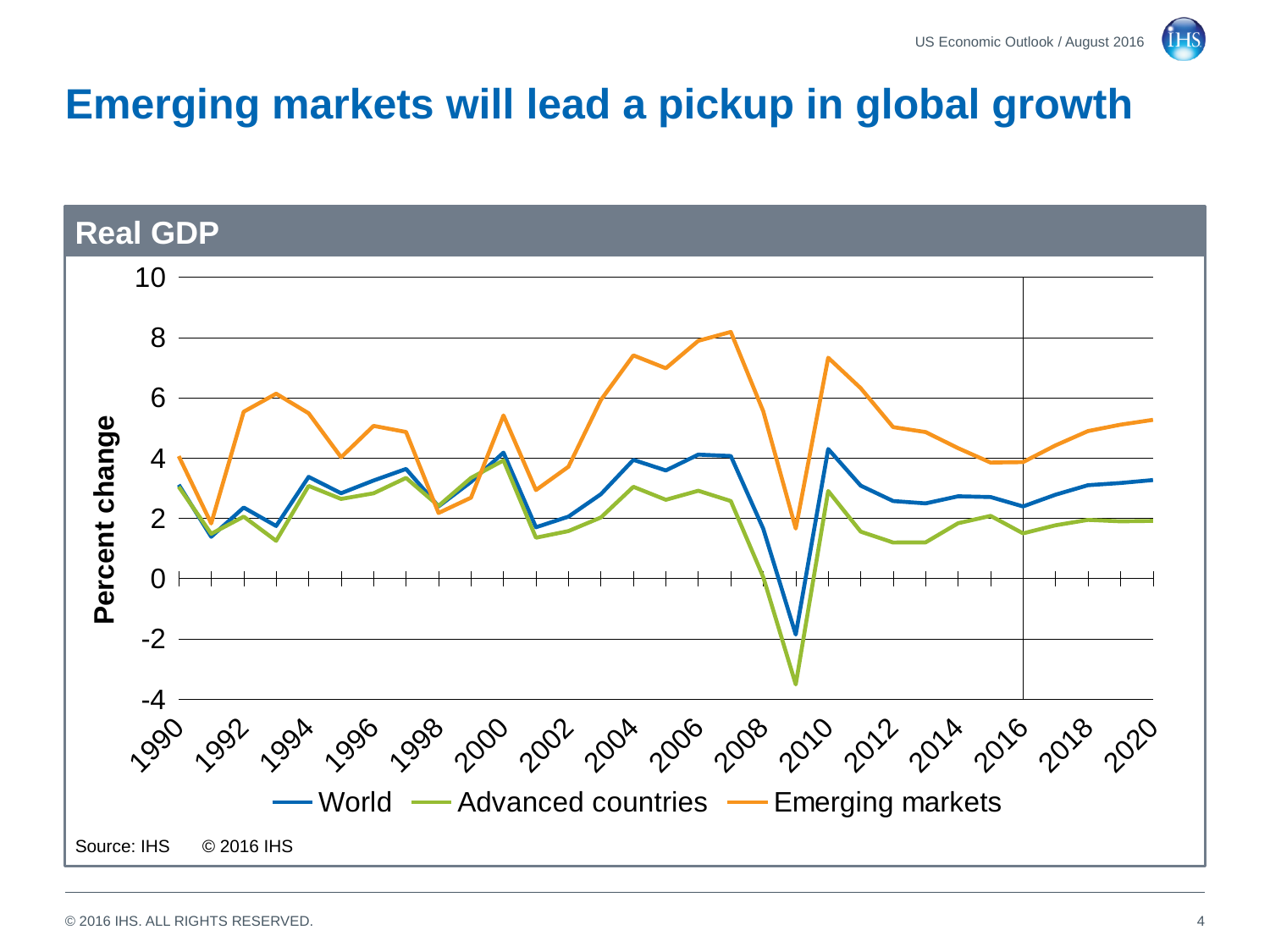
What kind of chart is shown on the slide? Line chart Does the Emerging markets series rise or fall from 2016 to 2020? Rise In which year does the Advanced countries series reach its lowest value? 2009 What is the title of the chart? Real GDP Is the value for Advanced countries in 2009 greater or less than -2? less In 2020, which series has a higher value, Emerging markets or Advanced countries? Emerging markets What is the label on the vertical axis? Percent change In 2009, which series has a higher value, World or Advanced countries? World Is the value for World in 2009 greater or less than 0? less Is the value for Emerging markets in 2020 greater or less than 4? greater How many series does the legend list? 3